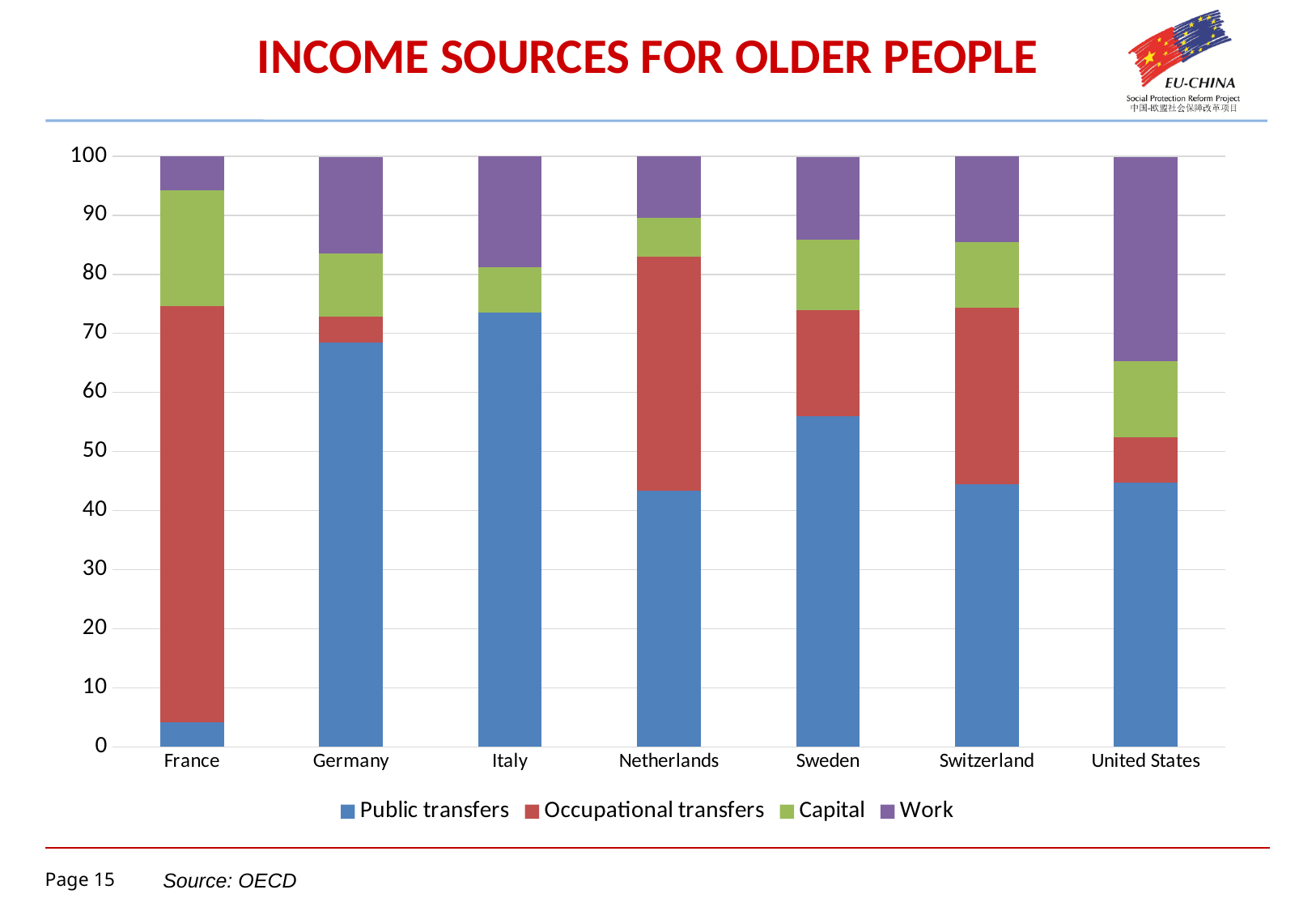
Which country has the largest Work segment? United States Which country has the smallest Public transfers segment? France How many series does the legend list? 4 Which country has the largest Public transfers segment? Italy Which country has the largest Occupational transfers segment? France Is the Public transfers value for Netherlands greater or less than 50? less Is the Public transfers value for Sweden greater or less than 50? greater What kind of chart is shown on the slide? Stacked bar chart What source is cited for the chart data? OECD What is the total height of the stacked bar for France? 100 How many countries are shown on the x axis of the chart? 7 Which is larger, the Public transfers segment for Germany or for Netherlands? Germany